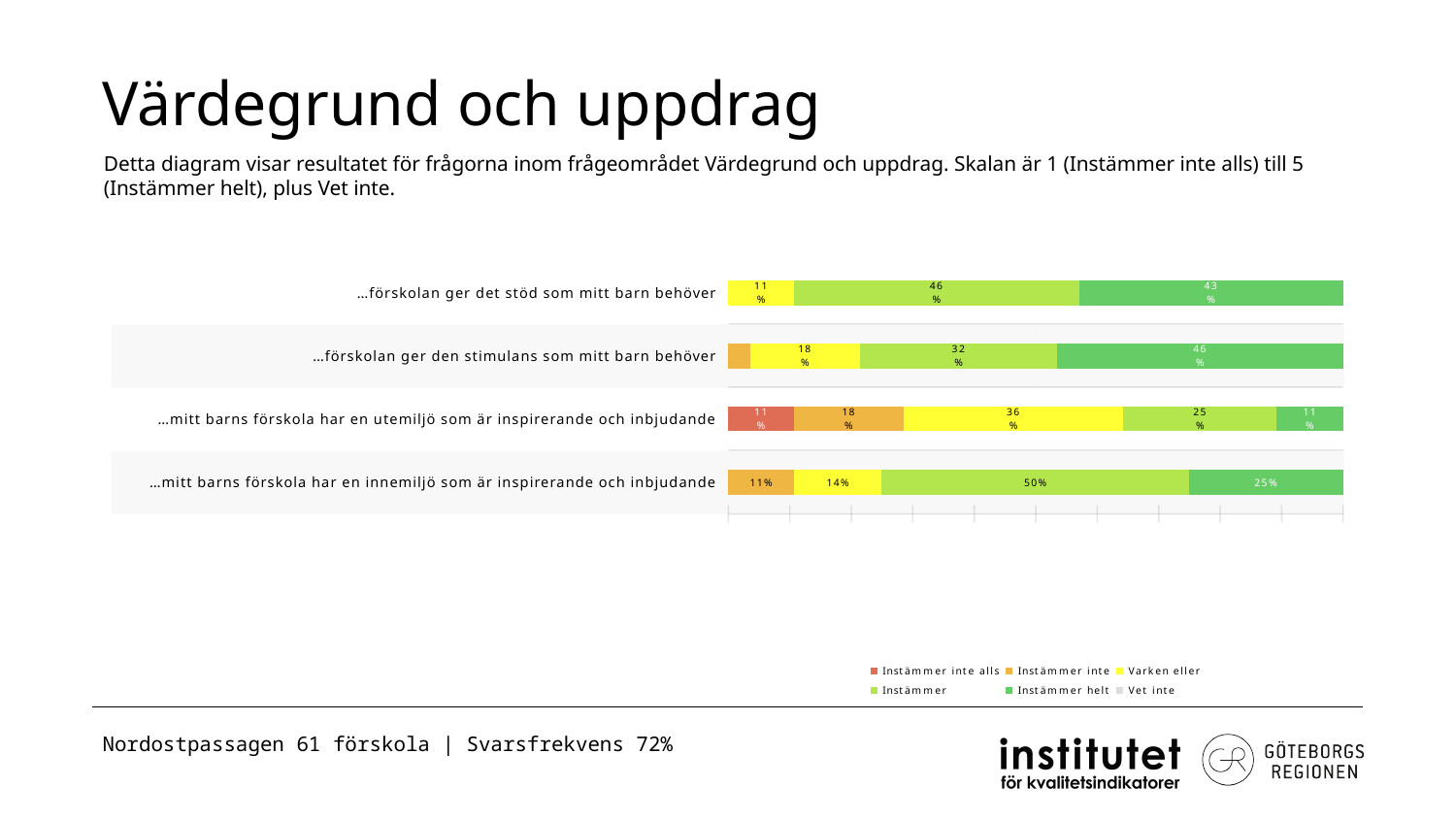
How many series does the legend list? 6 Which category has the highest 'Instämmer helt' value? …förskolan ger den stimulans som mitt barn behöver What is the 'Instämmer inte alls' value for '…mitt barns förskola har en utemiljö som är inspirerande och inbjudande'? 11% Which category has the lowest 'Instämmer helt' value? …mitt barns förskola har en utemiljö som är inspirerande och inbjudande What is the 'Instämmer' value for '…mitt barns förskola har en innemiljö som är inspirerande och inbjudande'? 50% How many categories (questions) are plotted in the chart? 4 What is the difference between the 'Instämmer' values for '…förskolan ger det stöd som mitt barn behöver' and '…förskolan ger den stimulans som mitt barn behöver'? 14% What is the 'Instämmer helt' value for '…förskolan ger det stöd som mitt barn behöver'? 43% What kind of chart is shown on the slide? stacked bar chart What is the title of the slide containing the chart? Värdegrund och uppdrag Which is larger: the 'Instämmer helt' value for '…mitt barns förskola har en innemiljö som är inspirerande och inbjudande' or for '…mitt barns förskola har en utemiljö som är inspirerande och inbjudande'? …mitt barns förskola har en innemiljö som är inspirerande och inbjudande What is the 'Varken eller' value for '…mitt barns förskola har en utemiljö som är inspirerande och inbjudande'? 36%